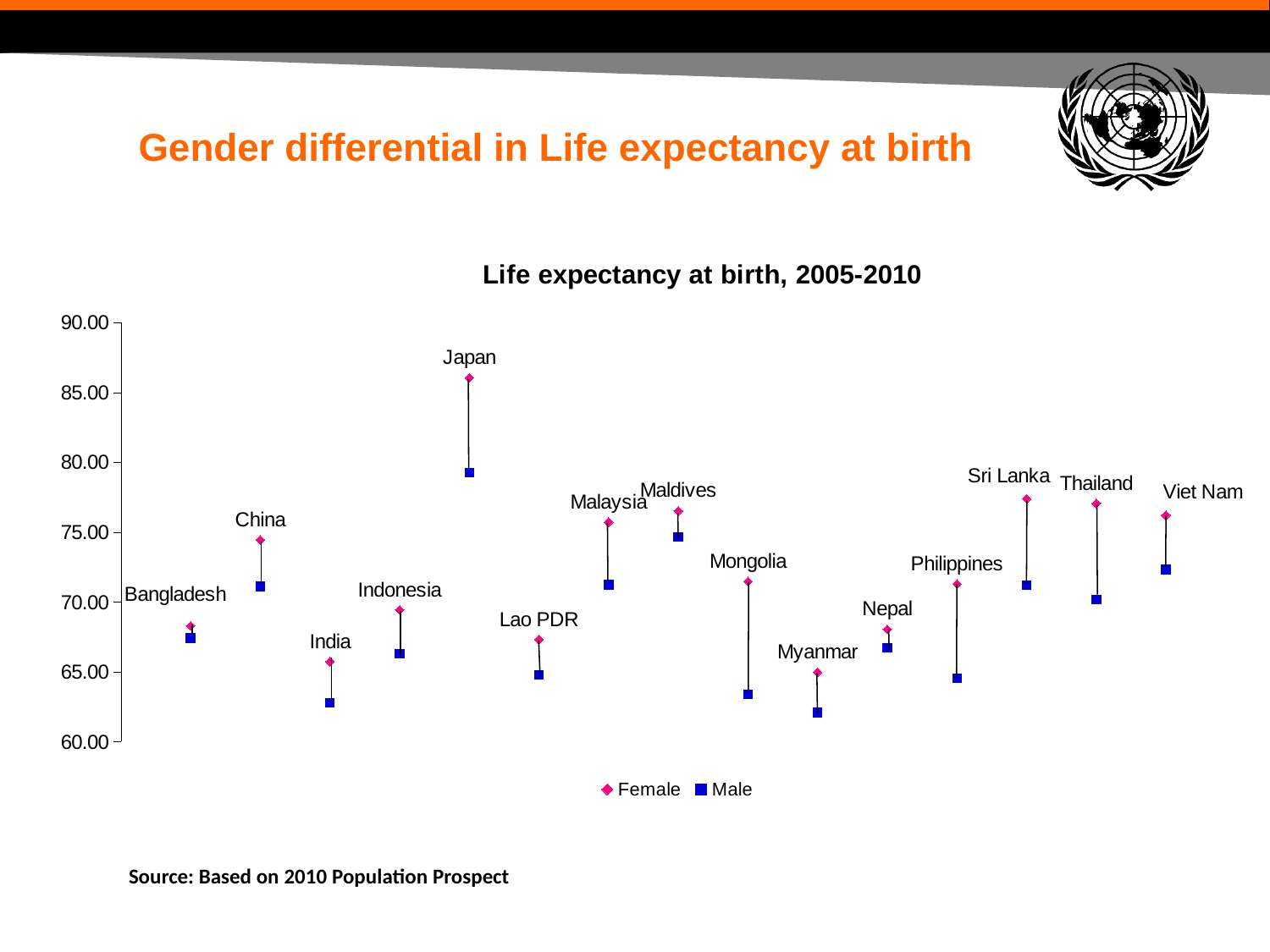
Which country has the highest female life expectancy at birth? Japan Is the male life expectancy for Japan greater or less than 80? less Which is larger, the male life expectancy for Viet Nam or for the Philippines? Viet Nam Is the female life expectancy for Bangladesh greater or less than 70? less How many countries are plotted on the chart? 15 Which country has the highest male life expectancy at birth? Japan How many series does the chart legend list? 2 Is the female life expectancy for Sri Lanka greater or less than 75? greater Which is larger, the female life expectancy for Mongolia or for Nepal? Mongolia What is the title of the chart? Life expectancy at birth, 2005-2010